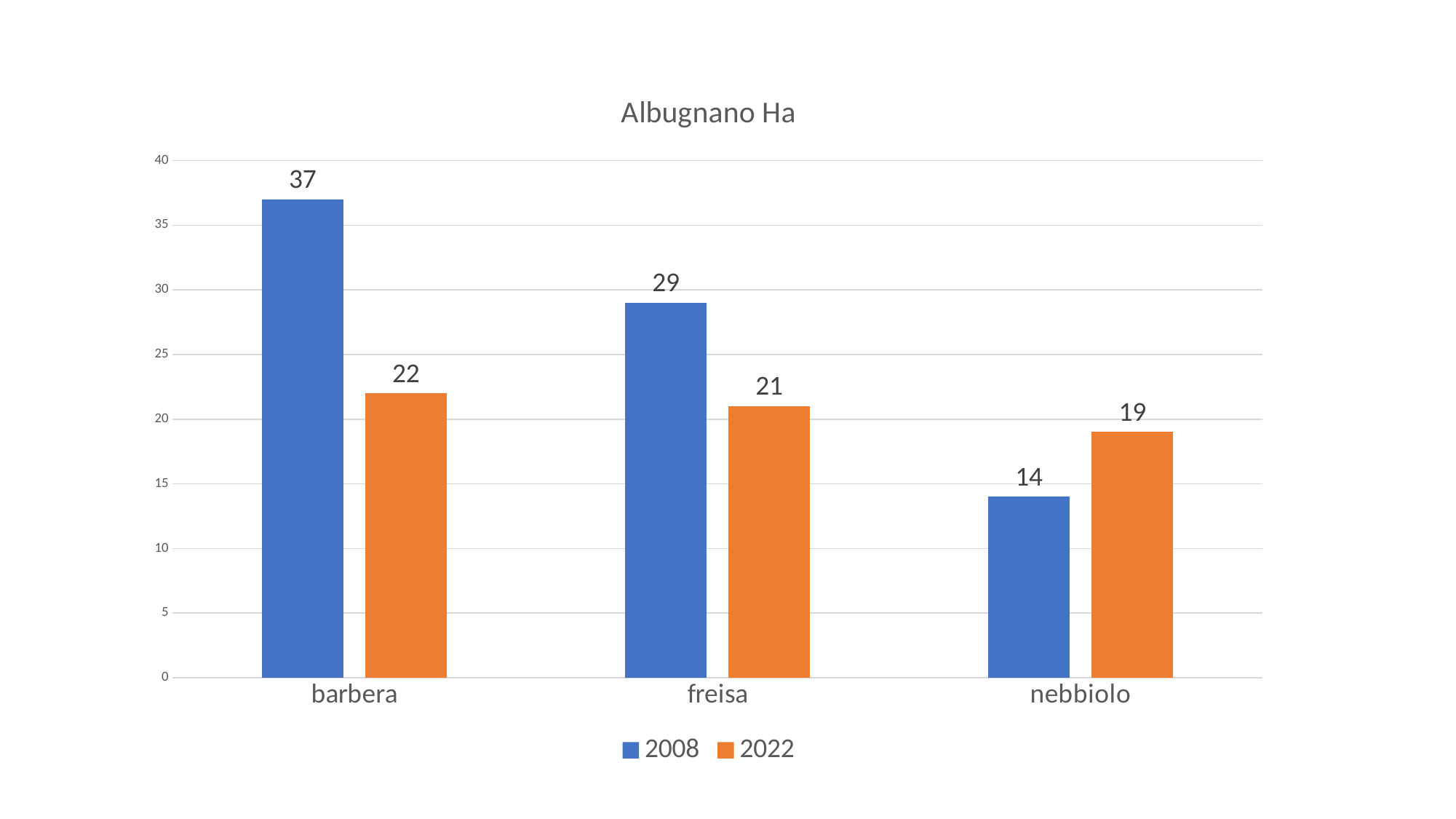
What kind of chart is shown on the slide? bar chart Is the value for freisa in 2008 greater or less than 25? greater What is the title of the chart? Albugnano Ha What is the value for nebbiolo in 2022? 19 Which category has the lowest value in the 2022 series? nebbiolo What is the value for barbera in 2008? 37 How many categories are shown on the x axis? 3 What is the difference between the 2008 and 2022 values for barbera? 15 Which category has the highest value in the 2008 series? barbera What is the value for freisa in 2022? 21 How many series does the legend list? 2 Which is larger for nebbiolo, the 2008 value or the 2022 value? 2022